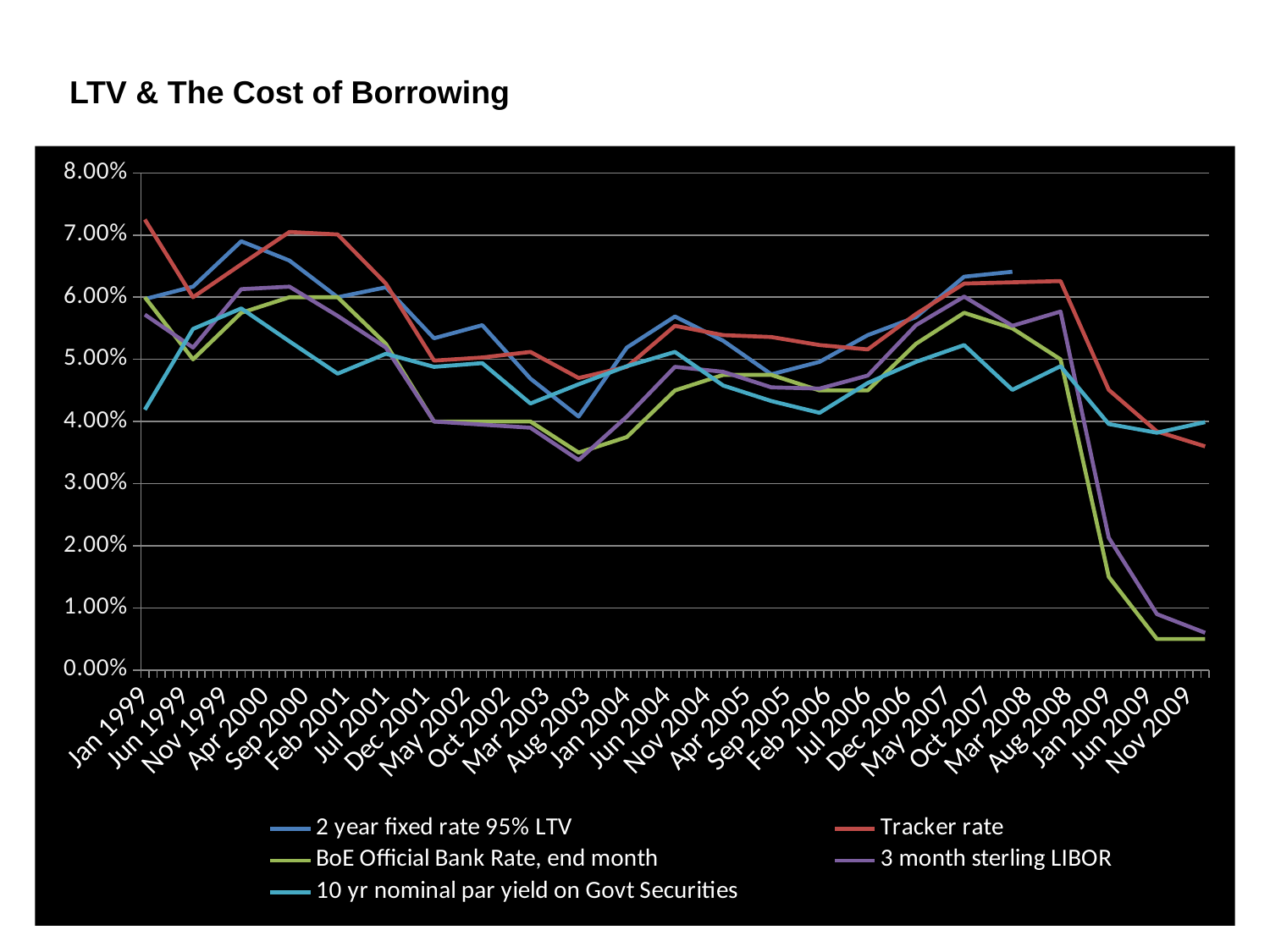
Is the value for the Tracker rate in Nov 2009 greater or less than 4.00%? less What is the title of the slide containing the chart? LTV & The Cost of Borrowing Which series has the highest value in Nov 2009? 10 yr nominal par yield on Govt Securities Is the value for the 2 year fixed rate 95% LTV in Apr 2000 greater or less than 6.00%? greater Which series is drawn in red? Tracker rate In Nov 2009, which is higher: the Tracker rate or the BoE Official Bank Rate, end month? Tracker rate Is the value for the BoE Official Bank Rate, end month in Nov 2009 greater or less than 1.00%? less Does the BoE Official Bank Rate, end month rise or fall between Aug 2008 and Jun 2009? fall What kind of chart is shown on the slide? Line chart How many series does the legend list? 5